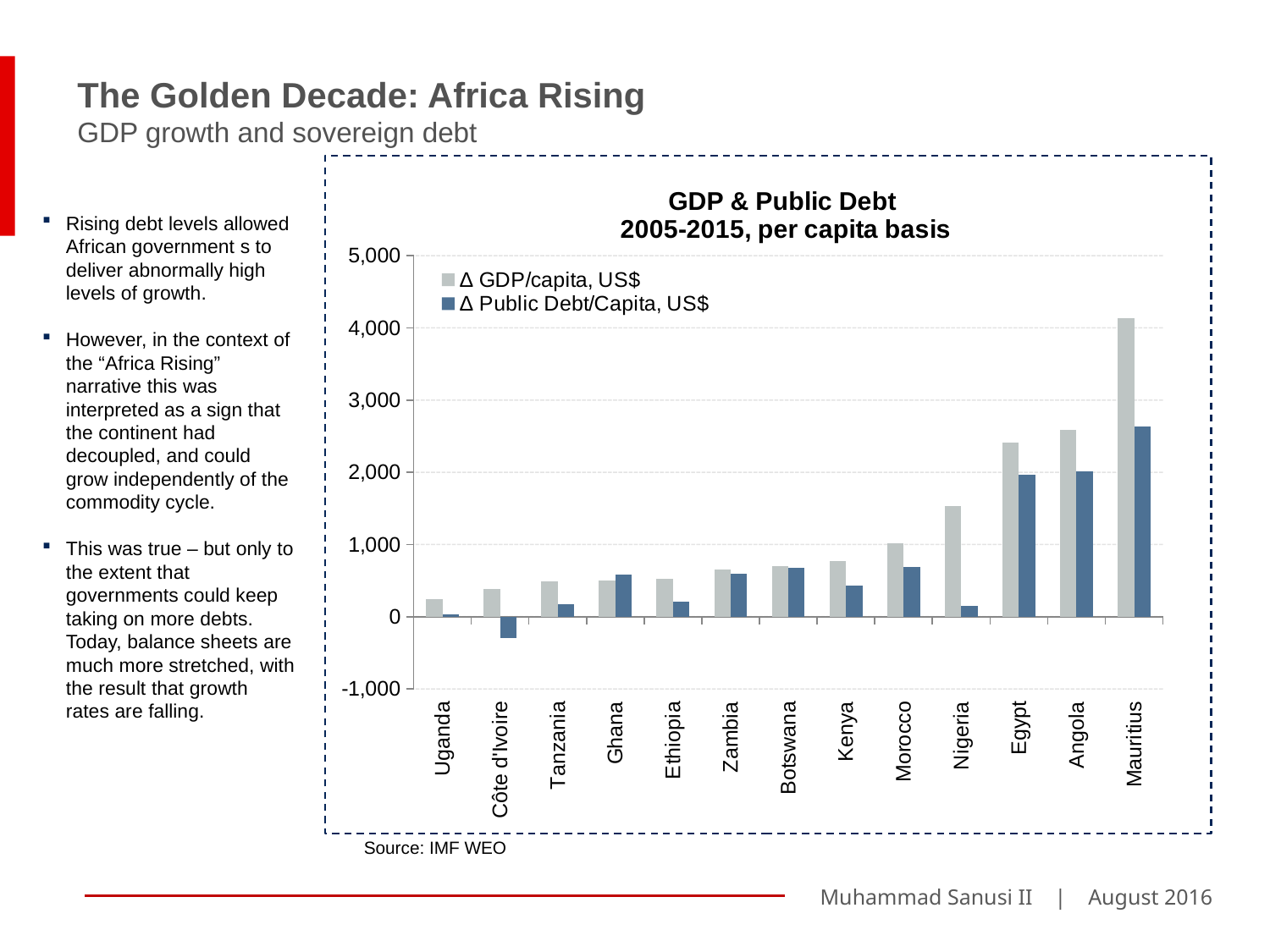
Is the Δ Public Debt/Capita value for Egypt greater or less than 1,000? greater What is the title of the chart? GDP & Public Debt 2005-2015, per capita basis Is the Δ GDP/capita value for Mauritius greater or less than 3,000? greater Which country has the highest Δ GDP/capita, US$ value? Mauritius Do the Δ GDP/capita bars generally rise or fall from Uganda to Mauritius along the x axis? Rise What kind of chart is shown on the slide? Bar chart Which country has the lowest Δ Public Debt/Capita, US$ value? Côte d'Ivoire For Nigeria, which is larger: Δ GDP/capita or Δ Public Debt/Capita? Δ GDP/capita Is the Δ GDP/capita value for Nigeria greater or less than 1,000? greater How many series does the chart's legend list? 2 How many countries are shown on the x axis of the chart? 13